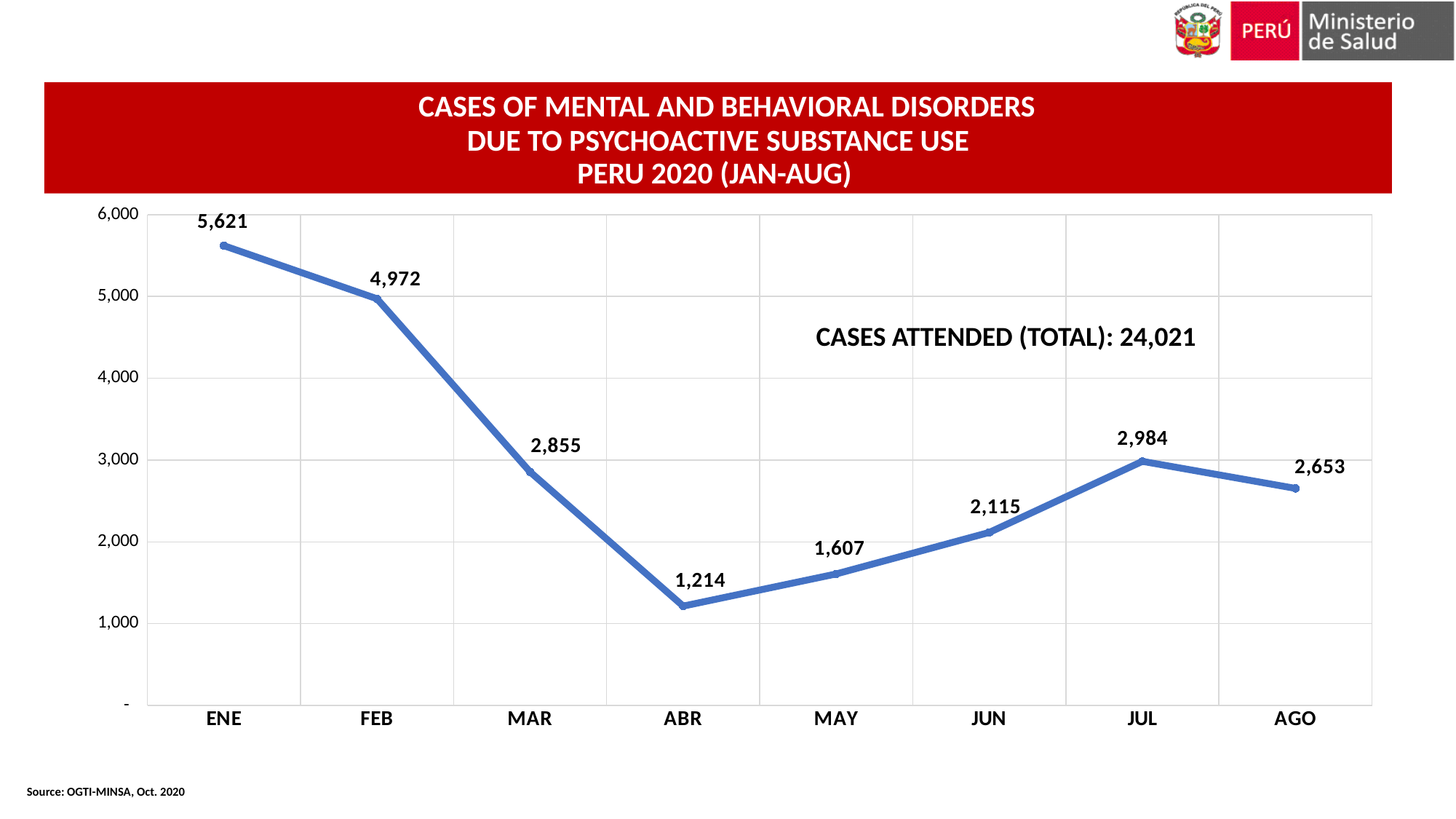
What is the difference in cases between JUL and AGO? 331 What is the number of cases for ABR? 1,214 Is the value for MAY greater or less than 2,000? less What is the number of cases for JUL? 2,984 Which month has the highest number of cases? ENE Do the values rise or fall from ENE to ABR? fall What is the number of cases for ENE? 5,621 Which month has more cases, MAR or JUN? MAR What kind of chart is shown on the slide? Line chart What is the difference in cases between ENE and FEB? 649 How many months are plotted on the chart? 8 Which month has the lowest number of cases? ABR